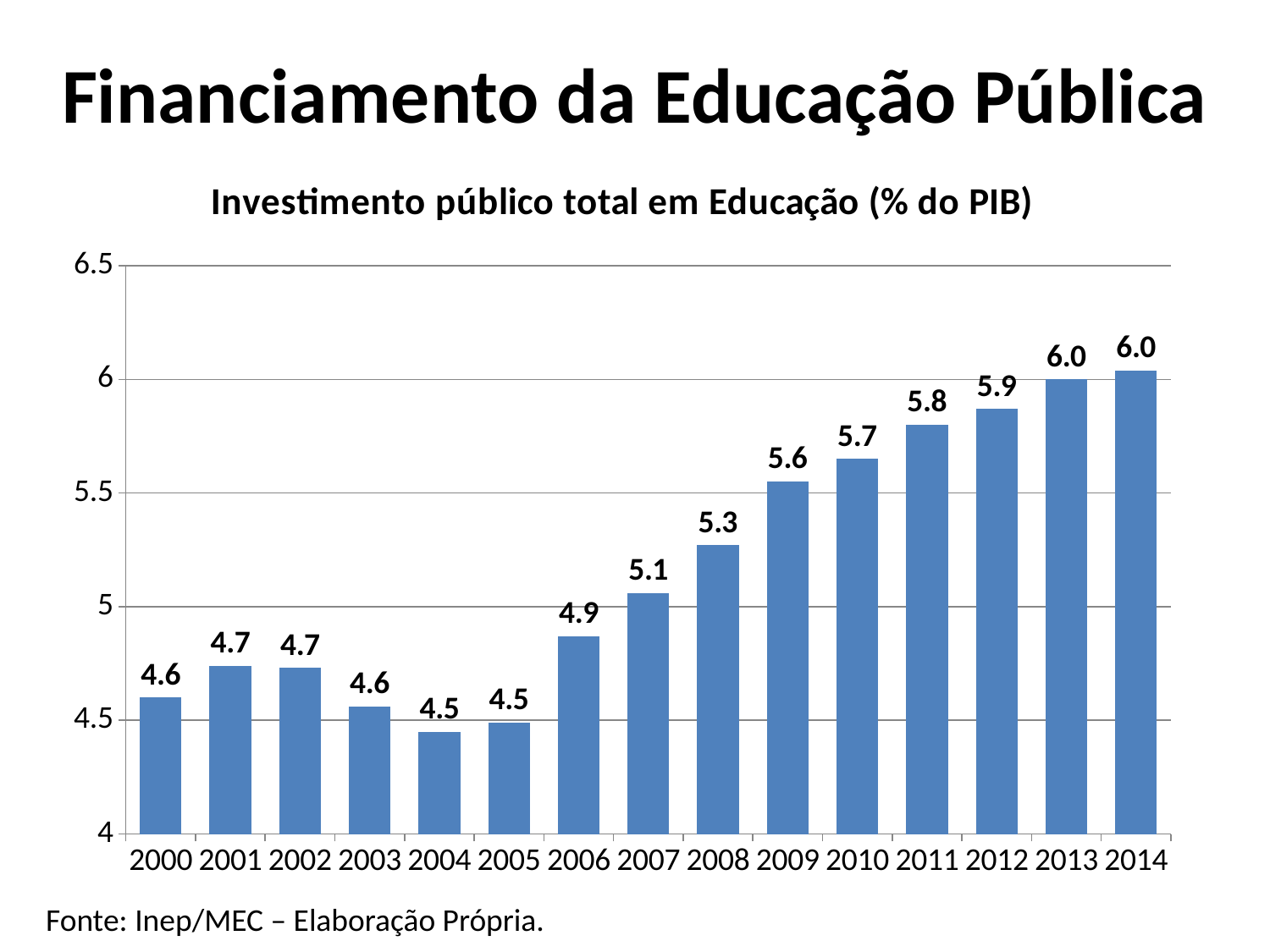
Which is larger, the value for 2008 or the value for 2002? 2008 What is the difference between the values for 2009 and 2006? 0.7 What is the value for 2000? 4.6 What is the difference between the values for 2014 and 2000? 1.4 Do the values rise or fall from 2005 to 2014? Rise How many years are shown on the x axis? 15 What is the value for 2012? 5.9 What is the title of the chart? Investimento público total em Educação (% do PIB) What is the value for 2008? 5.3 What kind of chart is shown on the slide? Bar chart Is the value for 2010 greater or less than 5.5? greater What is the value for 2006? 4.9